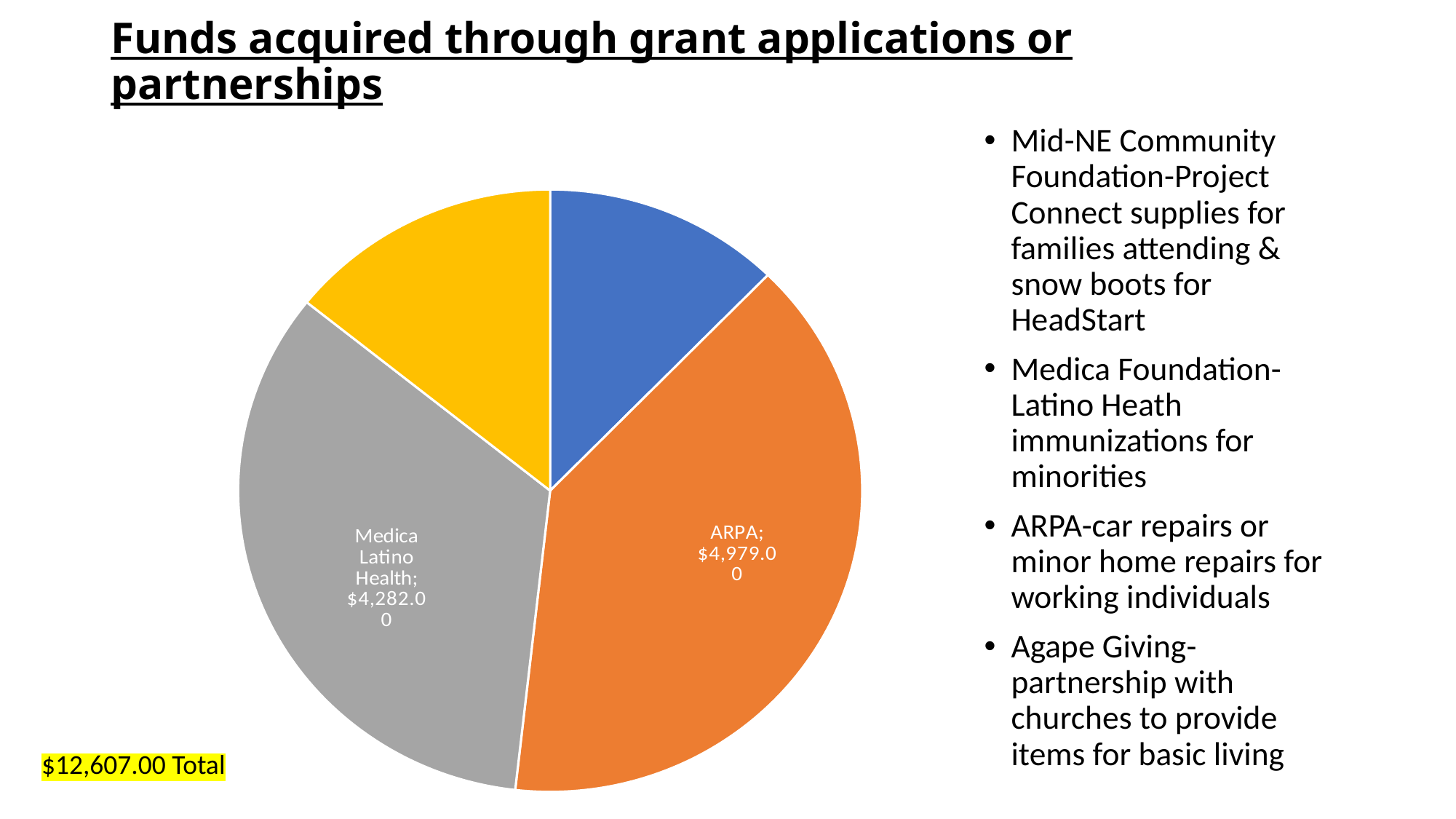
Which labelled slice is the largest in the pie chart? ARPA What total amount is shown in the highlighted text next to the pie chart? $12,607.00 How many slices does the pie chart have? 4 What is the value shown for the ARPA slice? $4,979.00 What is the title of the slide containing the pie chart? Funds acquired through grant applications or partnerships What is the value shown for the Medica Latino Health slice? $4,282.00 Which is larger, the ARPA slice or the Medica Latino Health slice? ARPA What is the difference between the ARPA value and the Medica Latino Health value? $697.00 What kind of chart is shown on the slide? pie chart What colour is the ARPA slice in the pie chart? orange